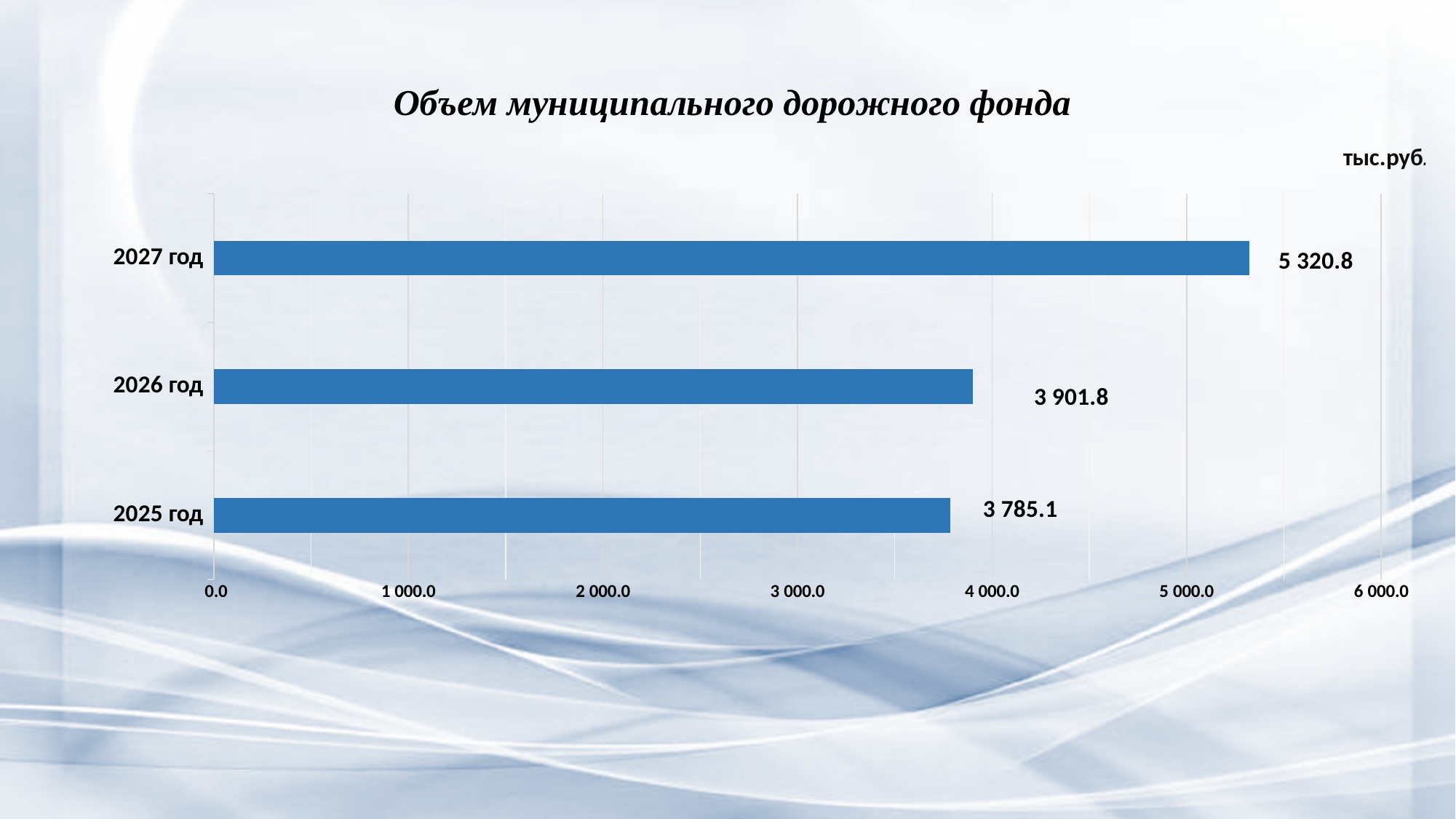
What is the value for 2025 год? 3 785.1 Which year has the highest value? 2027 год Which year has the lowest value? 2025 год How many years are shown in the chart? 3 What kind of chart is shown on the slide? bar chart What is the value for 2026 год? 3 901.8 Is the value for 2027 год greater or less than 5 000.0? greater What is the value for 2027 год? 5 320.8 Which is larger, the value for 2027 год or the value for 2025 год? 2027 год What is the title of the chart? Объем муниципального дорожного фонда What is the difference between the values for 2027 год and 2026 год? 1 419.0 What is the difference between the values for 2026 год and 2025 год? 116.7